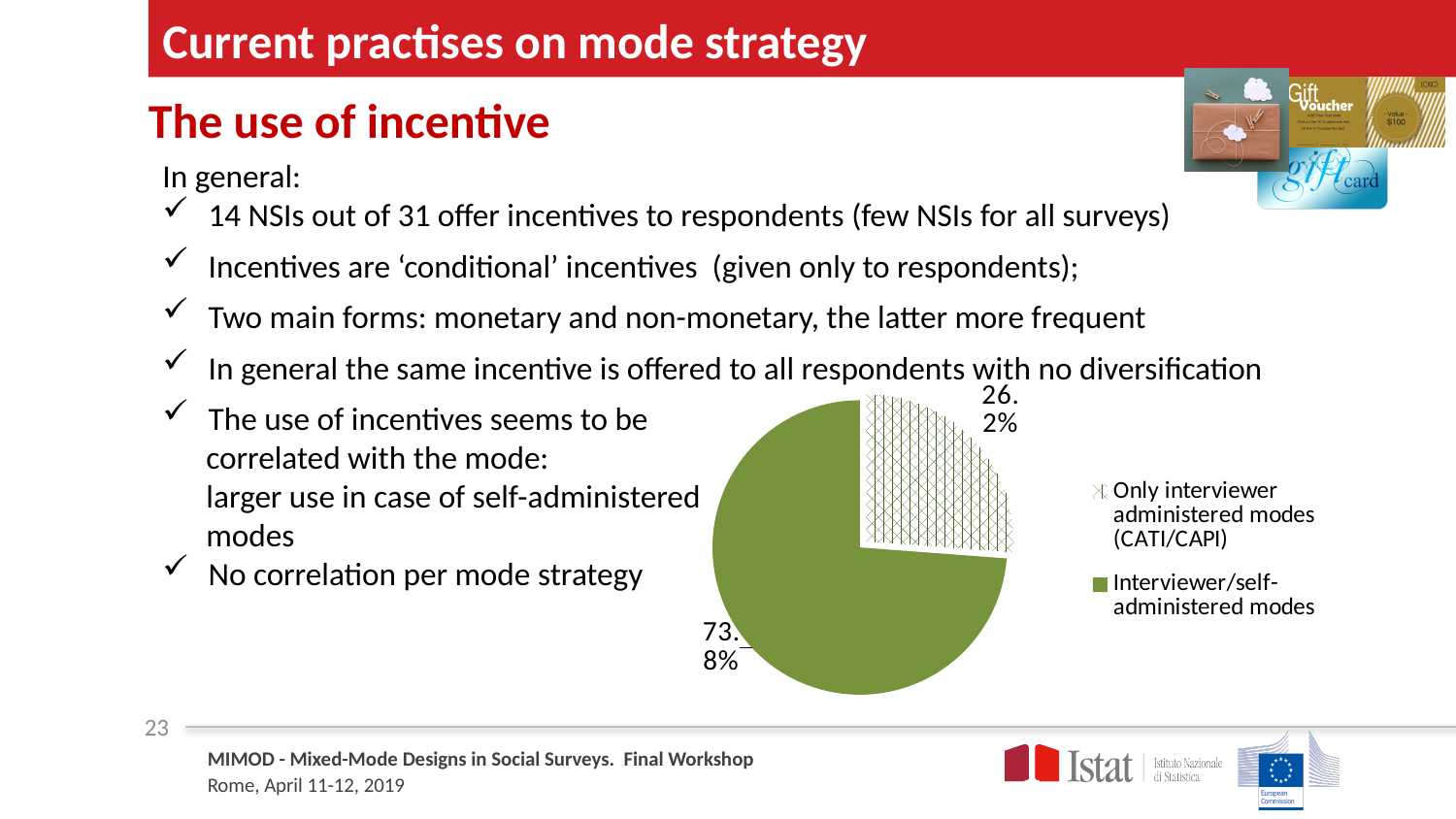
How many slices does the pie chart have? 2 What share of the pie is labelled for Interviewer/self-administered modes? 73.8% What kind of chart is shown on the slide? pie chart What is the difference in percentage points between the Interviewer/self-administered modes slice and the Only interviewer administered modes (CATI/CAPI) slice? 47.6 How many entries does the legend of the pie chart list? 2 Which is larger in the pie chart: the Only interviewer administered modes (CATI/CAPI) slice or the Interviewer/self-administered modes slice? Interviewer/self-administered modes Which legend entry is shown with a hatched (cross-hatch) pattern? Only interviewer administered modes (CATI/CAPI) Which slice of the pie chart is the largest? Interviewer/self-administered modes What colour is the Interviewer/self-administered modes slice in the pie chart? green Which slice of the pie chart is the smallest? Only interviewer administered modes (CATI/CAPI) What share of the pie is labelled for Only interviewer administered modes (CATI/CAPI)? 26.2% Is the share for Only interviewer administered modes (CATI/CAPI) greater or less than 50%? less